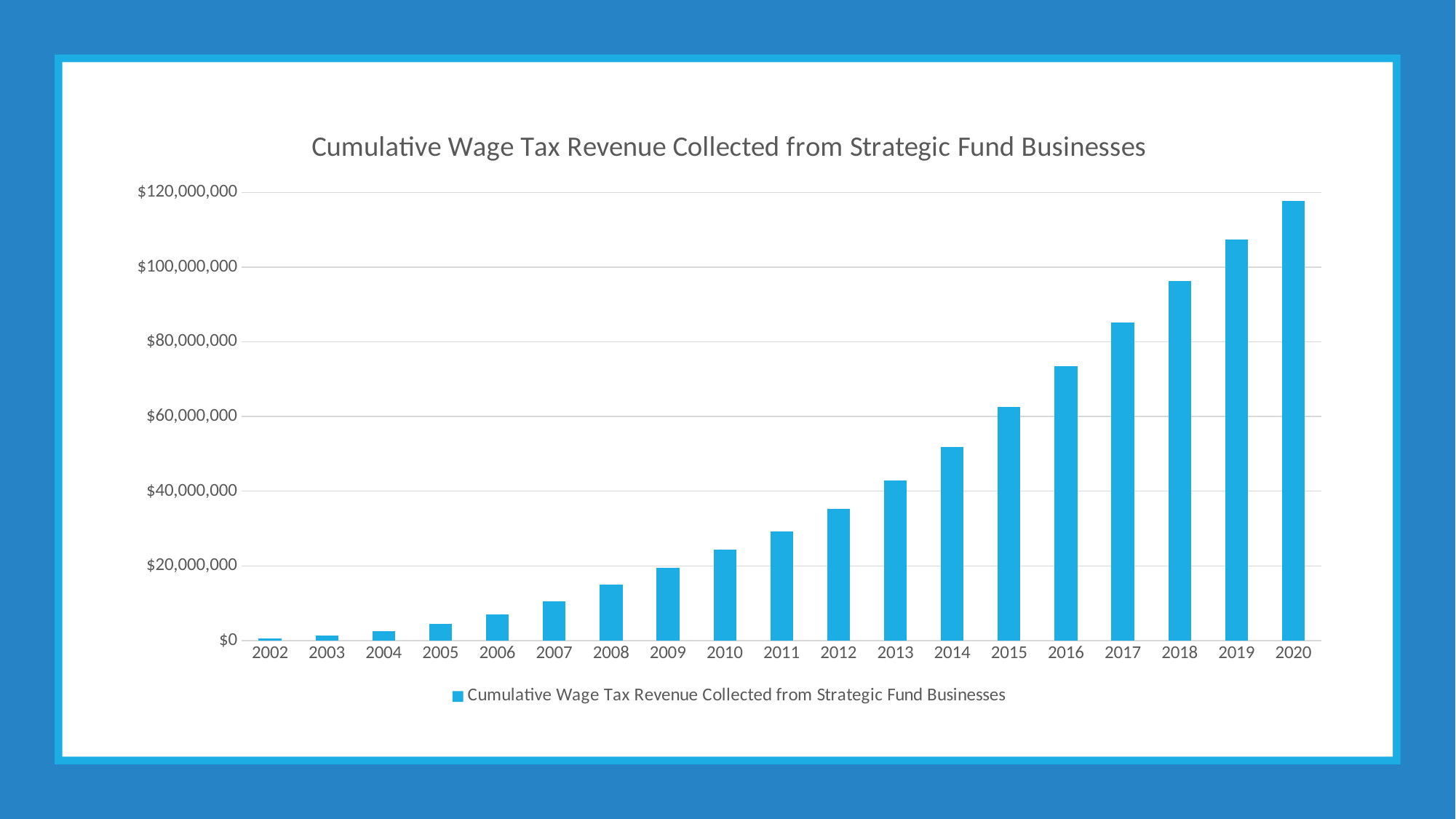
Is the value for 2018 greater or less than $100,000,000? less How many years are shown on the x axis? 19 What kind of chart is shown on the slide? bar chart Which year has the larger value, 2013 or 2016? 2016 Is the value for 2010 greater or less than $20,000,000? greater Is the value for 2020 greater or less than $100,000,000? greater Which year has the highest cumulative wage tax revenue? 2020 Do the values rise or fall from 2002 to 2020? rise Which year has the lowest cumulative wage tax revenue? 2002 How many series does the legend list? 1 What is the title of the chart? Cumulative Wage Tax Revenue Collected from Strategic Fund Businesses